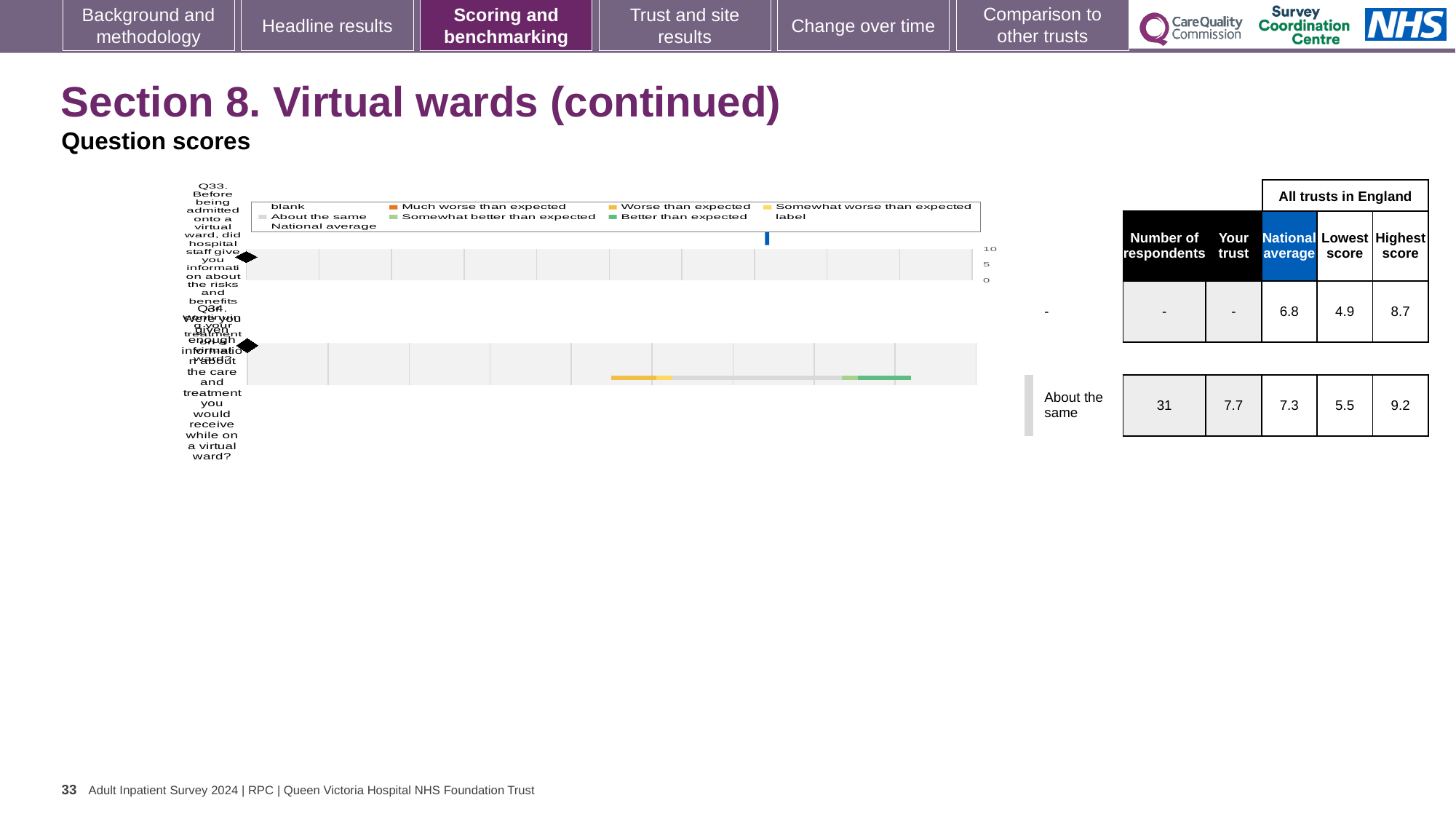
Which is larger for Q34: the 'Your trust' score or the national average? Your trust What is the national average score for Q34? 7.3 What is the highest score among all trusts in England for Q33? 8.7 What is the 'Your trust' score for Q34 (enough information about care and treatment on a virtual ward)? 7.7 What is the national average score for Q33 (information about risks and benefits before admission to a virtual ward)? 6.8 How many questions (categories) are plotted in the chart? 2 What benchmark rating is shown for Q34? About the same What is the lowest score among all trusts in England for Q34? 5.5 What is the difference between the highest and lowest scores for Q34 across all trusts in England? 3.7 What is the number of respondents for Q34? 31 What is the difference between the 'Your trust' score and the national average for Q34? 0.4 What kind of chart is shown on the slide? bar chart